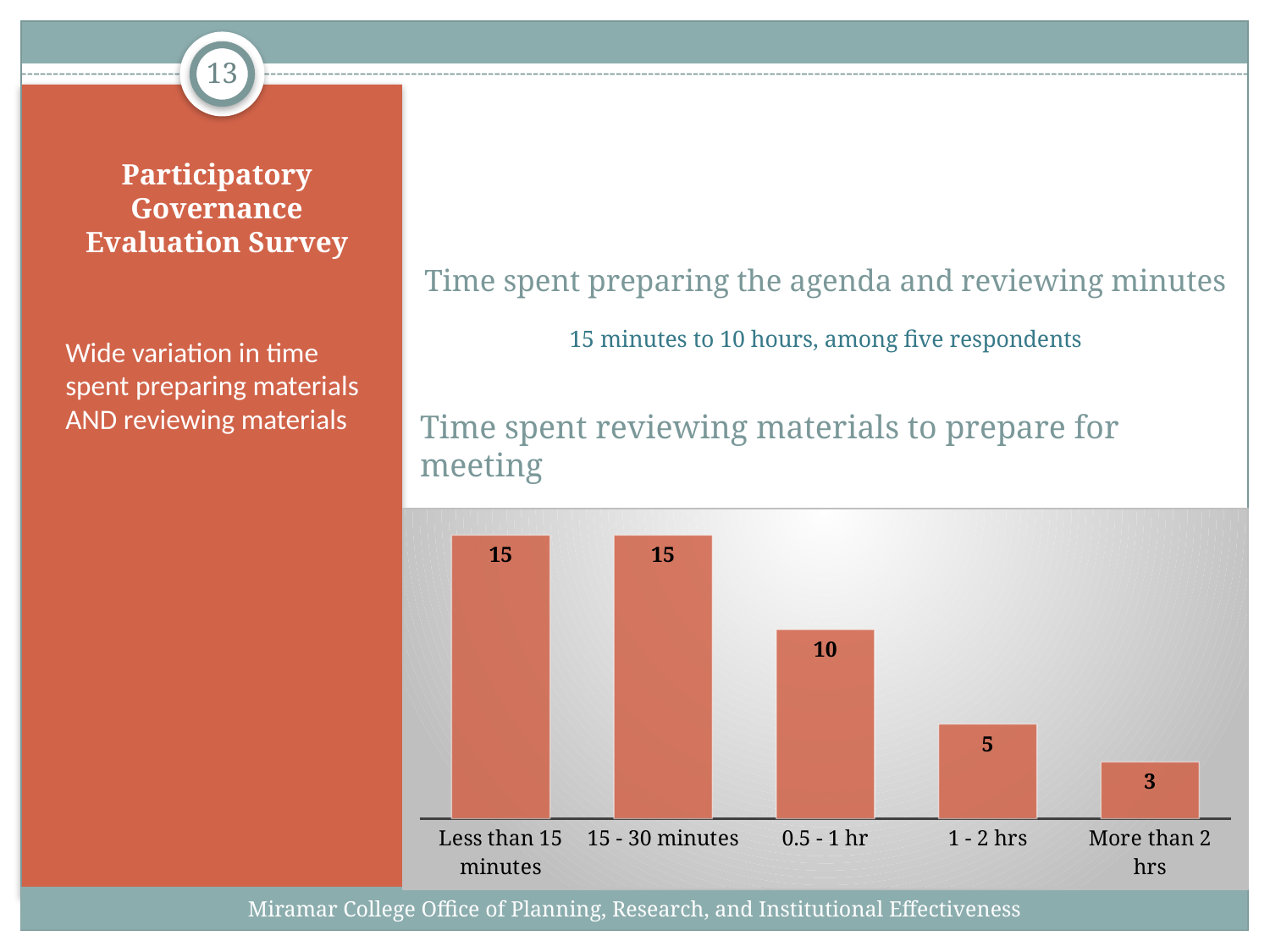
What kind of chart is shown on the slide? Bar chart What is the value for the '1 - 2 hrs' category? 5 What is the value for the '0.5 - 1 hr' category? 10 What is the difference between the values for '0.5 - 1 hr' and '1 - 2 hrs'? 5 How many categories are shown on the x axis of the chart? 5 Do the values rise or fall moving from left to right along the x axis? Fall What is the value for the 'Less than 15 minutes' category? 15 What is the difference between the values for '15 - 30 minutes' and 'More than 2 hrs'? 12 What is the value for the 'More than 2 hrs' category? 3 What is the title of the chart? Time spent reviewing materials to prepare for meeting Which is larger, the value for '0.5 - 1 hr' or the value for 'More than 2 hrs'? 0.5 - 1 hr Which category has the lowest value? More than 2 hrs